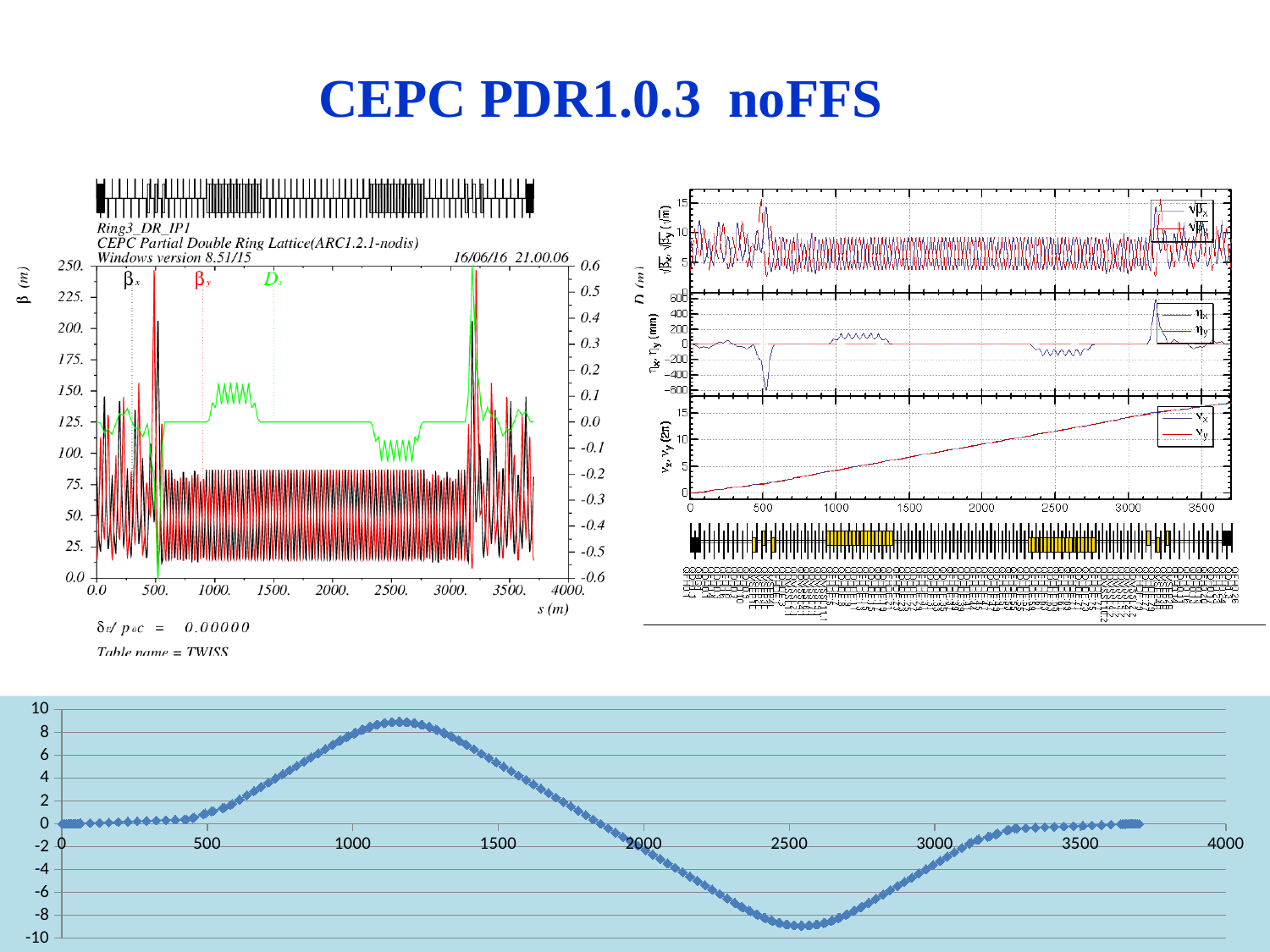
In the top-right chart, is the ηx value near s = 500 in the middle panel greater or less than -400? less In the bottom chart, is the value at x = 1200 greater or less than 5? greater In the bottom chart, do the values rise or fall as x goes from 500 to 1200? rise In the bottom chart, is the value at x = 2500 greater or less than -5? less In the bottom chart, do the values rise or fall as x goes from 1200 to 2500? fall In the top-right chart, do the νx and νy values in the bottom panel rise or fall as s increases from 0 to 3500? rise In the bottom chart, what is the highest value shown on the y axis? 10 In the top-left chart, how many series are labelled in the legend? 3 In the top-left chart, what colour is the Dx curve? green In the top-left chart, what is the highest value shown on the left y axis (β)? 250 In the bottom chart, is the value at x = 1200 larger or smaller than the value at x = 2500? larger